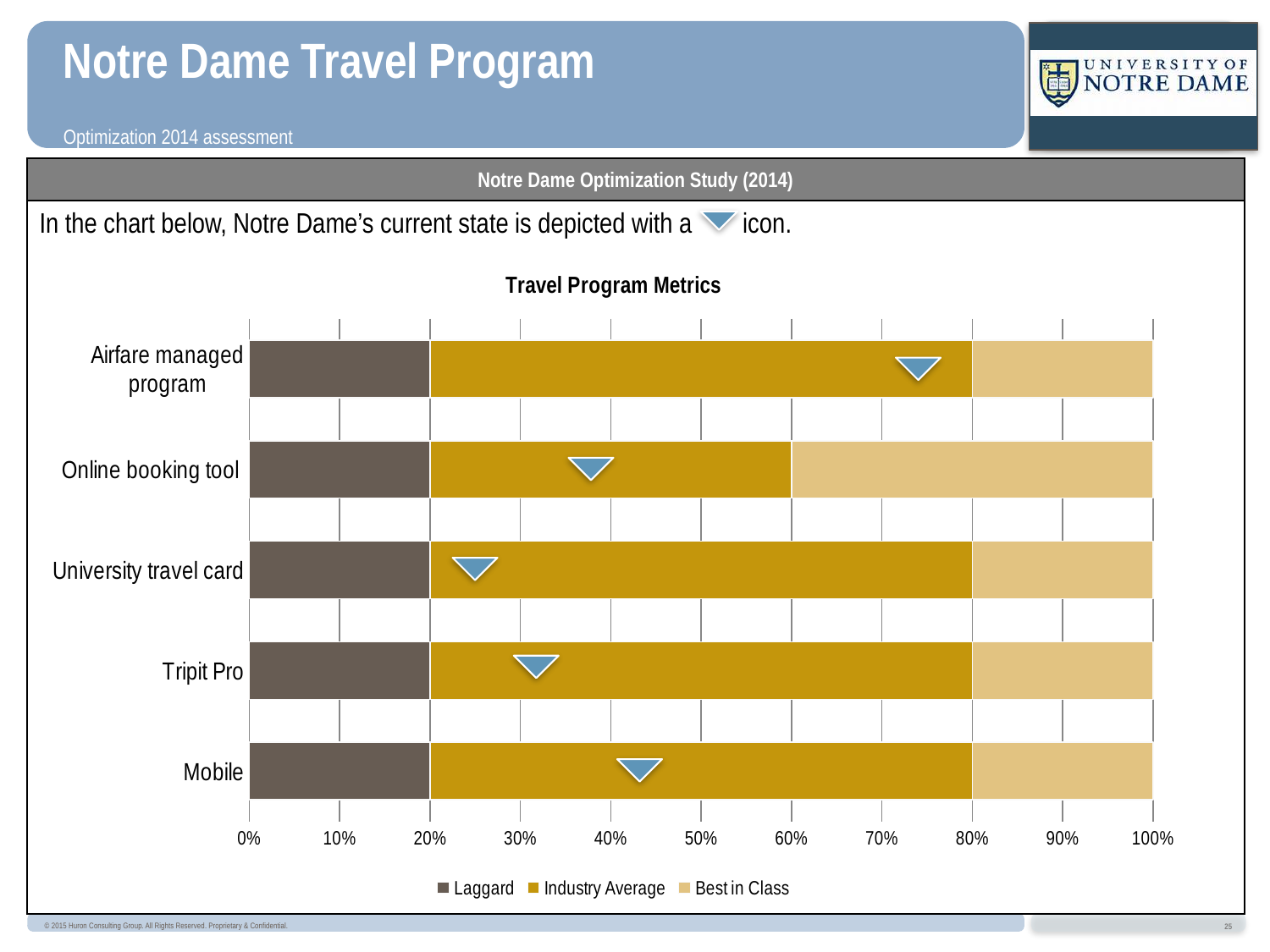
Is the Notre Dame current-state marker for Airfare managed program greater or less than 70%? greater At what percentage does the Laggard segment end for the Mobile bar? 20% Which category has the shortest Industry Average segment on the Travel Program Metrics chart? Online booking tool At what percentage does the Industry Average segment end for the Online booking tool bar? 60% Is the Notre Dame current-state marker for Tripit Pro greater or less than 40%? less Which category has the Notre Dame current-state marker furthest to the right: Airfare managed program or Mobile? Airfare managed program What are the three series listed in the legend of the Travel Program Metrics chart? Laggard, Industry Average, Best in Class What kind of chart is shown under the title "Travel Program Metrics"? Stacked bar chart How many series does the legend of the Travel Program Metrics chart list? 3 How many categories are plotted on the Travel Program Metrics chart? 5 At what percentage does the Industry Average segment end for the Tripit Pro bar? 80% Is the Notre Dame current-state marker for University travel card greater or less than 30%? less